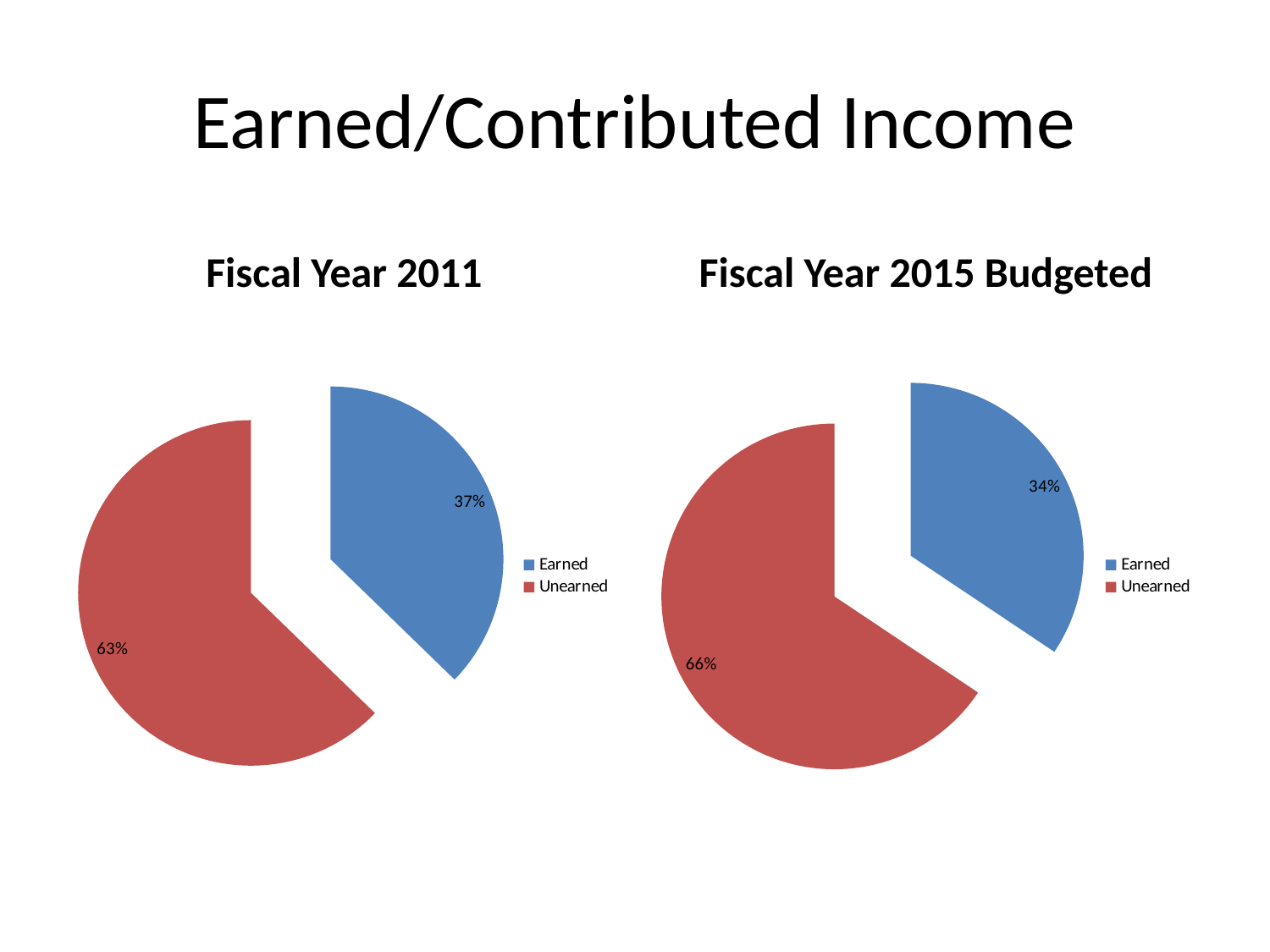
How many slices does the Fiscal Year 2015 Budgeted chart have? 2 In the Fiscal Year 2015 Budgeted chart, what is the difference in percentage points between Unearned and Earned? 32 In the Fiscal Year 2015 Budgeted chart, which category has the smallest slice? Earned In the Fiscal Year 2015 Budgeted chart, what share of income is Earned? 34% In the Fiscal Year 2011 chart, what colour is the Unearned slice? Red In the Fiscal Year 2011 chart, what share of income is Earned? 37% Is the Earned share larger in the Fiscal Year 2011 chart or the Fiscal Year 2015 Budgeted chart? Fiscal Year 2011 What kind of chart is the Fiscal Year 2011 chart? Pie chart In the Fiscal Year 2011 chart, what is the difference in percentage points between Unearned and Earned? 26 In the Fiscal Year 2011 chart, which category has the largest slice? Unearned In the Fiscal Year 2011 chart, what share of income is Unearned? 63% In the Fiscal Year 2015 Budgeted chart, what share of income is Unearned? 66%